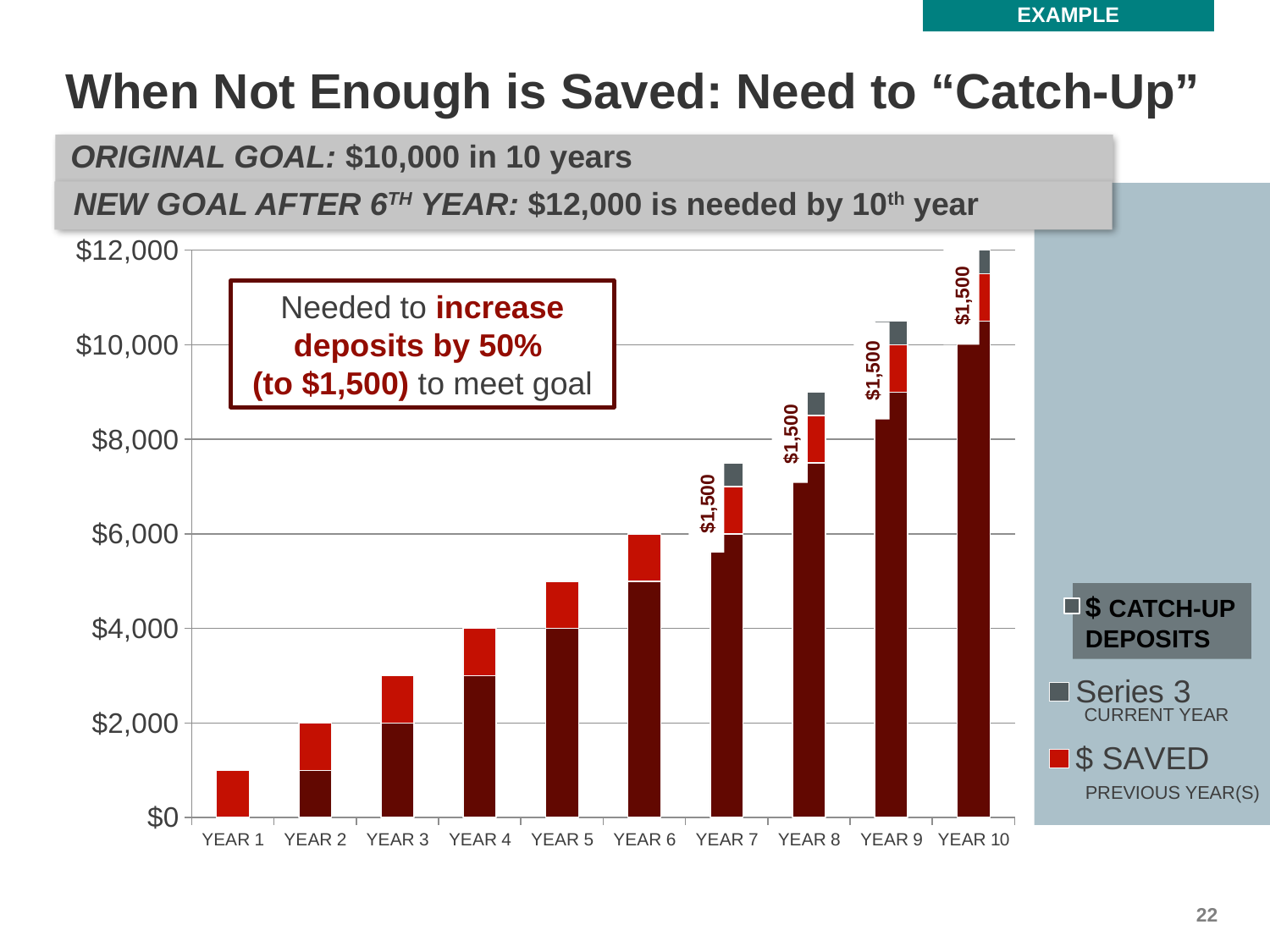
Which bar is taller, Year 9 or Year 5? Year 9 Which legend entry is shown in red? $ SAVED What is the data label shown on the Year 10 bar? $1,500 Is the total height of the Year 8 bar greater or less than $8,000? greater Which year has the tallest bar? Year 10 Which year has the shortest bar? Year 1 How many years (categories) are shown on the x axis of the chart? 10 How many series does the chart legend list? 3 Do the bar heights rise or fall from Year 1 to Year 10? rise What kind of chart is shown on the slide? bar chart Is the total height of the Year 3 bar greater or less than $4,000? less What is the data label shown on the Year 7 bar? $1,500